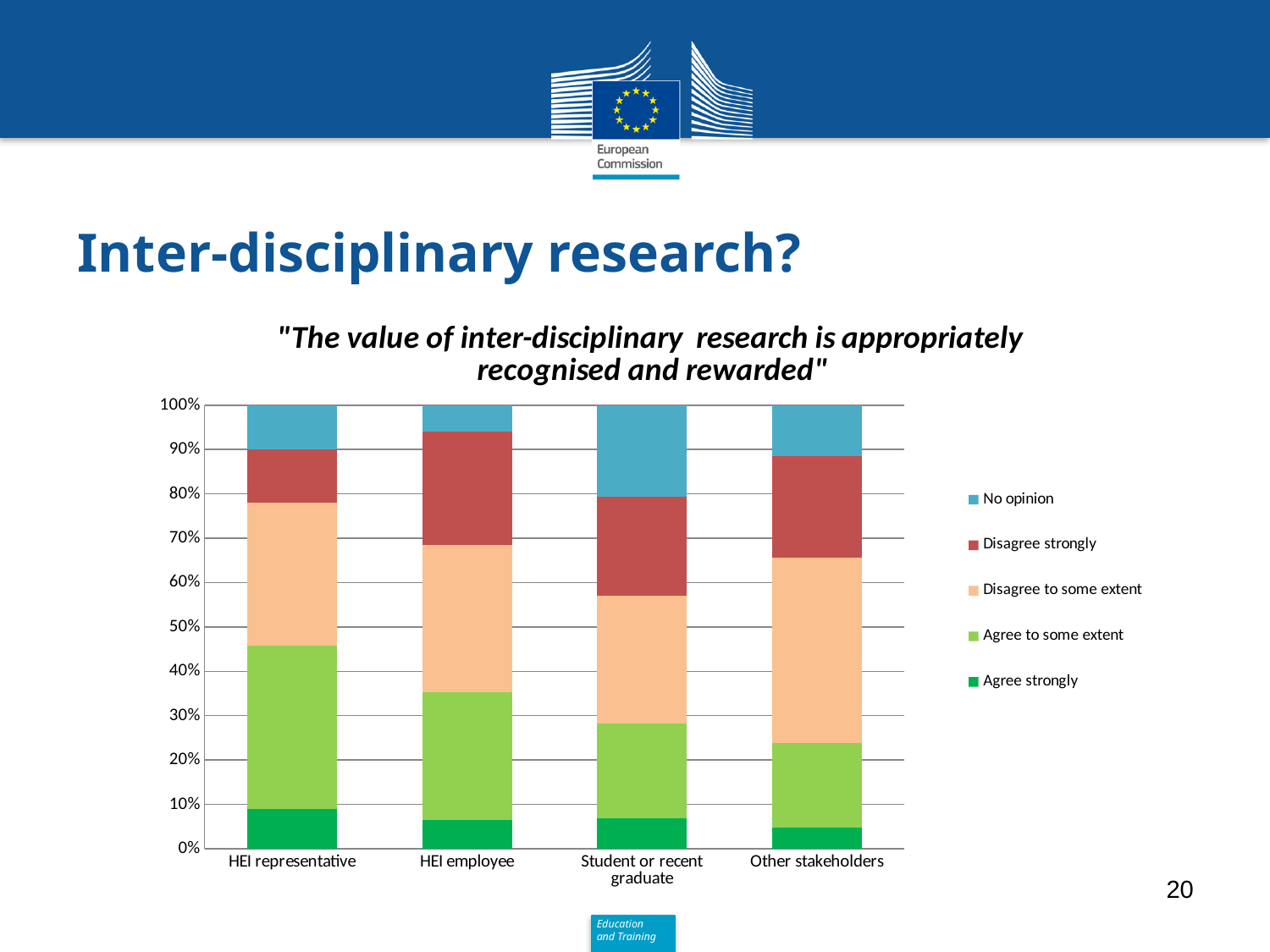
How many respondent categories are shown along the x axis? 4 Which respondent category has the smallest 'Disagree strongly' segment? HEI representative Which respondent category has the largest 'Disagree to some extent' segment? Other stakeholders Which respondent category has the largest 'No opinion' segment? Student or recent graduate How many series does the legend list? 5 In the HEI representative bar, is the top of the 'Agree to some extent' segment above or below 40%? above What kind of chart is shown on the slide? Stacked bar chart What statement is quoted in the chart title? "The value of inter-disciplinary research is appropriately recognised and rewarded" Which respondent category has the smallest 'Agree strongly' segment? Other stakeholders Which respondent category has the largest 'Agree to some extent' segment? HEI representative In the Other stakeholders bar, is the top of the 'Agree to some extent' segment above or below 30%? below Is the 'No opinion' segment larger for Student or recent graduate or for HEI employee? Student or recent graduate